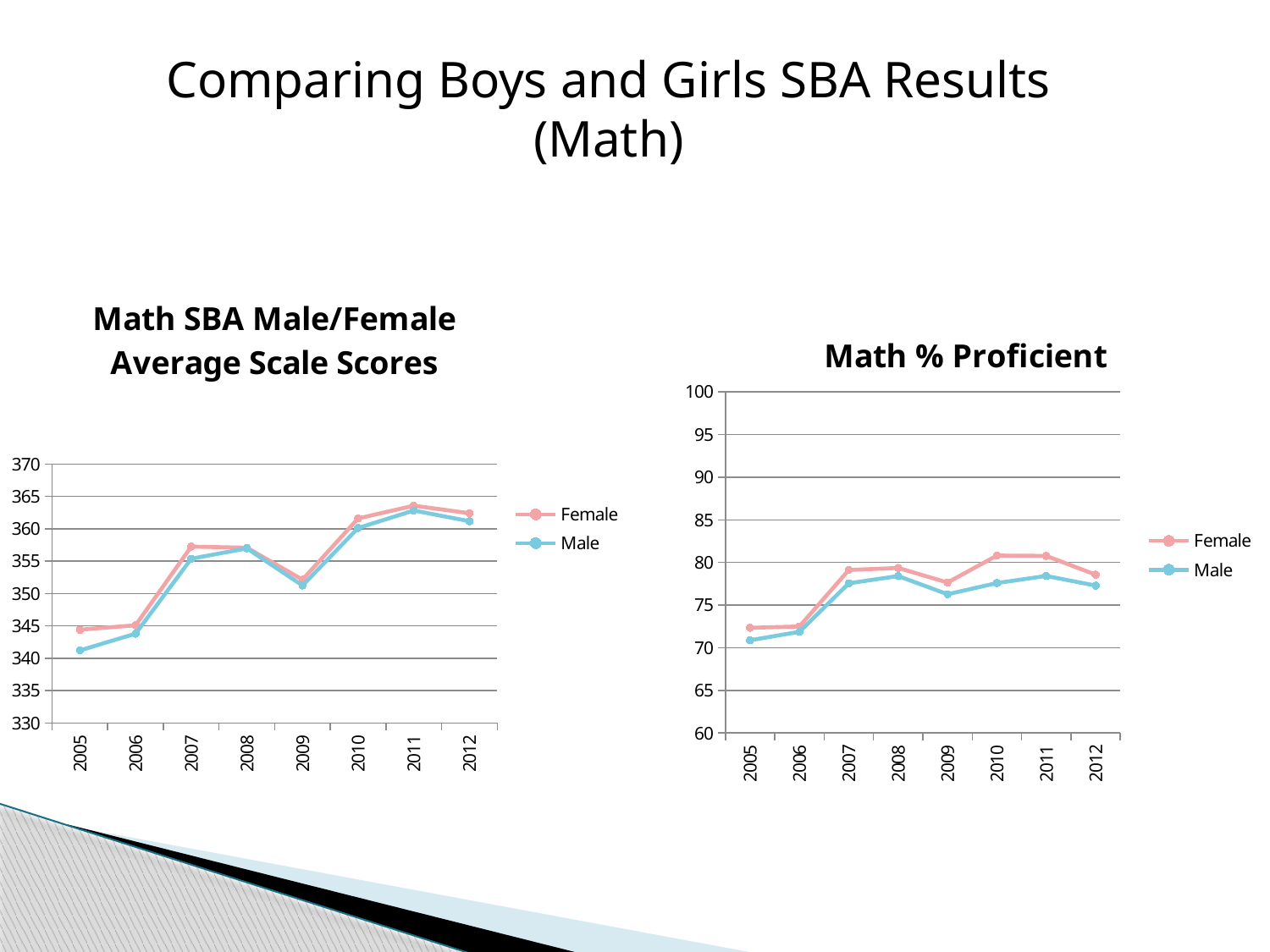
In the Math % Proficient chart, is the Male value for 2005 greater or less than 75? less How many years are plotted on the x axis of the Math % Proficient chart? 8 In the Math SBA Male/Female Average Scale Scores chart, is the Female value for 2007 greater or less than 355? greater In the Math SBA Male/Female Average Scale Scores chart, is the Male value for 2005 greater or less than 345? less In the Math SBA Male/Female Average Scale Scores chart, do the Female values rise or fall from 2009 to 2011? rise In the Math % Proficient chart, in which year is the Male series at its lowest? 2005 What kind of chart is the Math SBA Male/Female Average Scale Scores chart? line chart In the Math % Proficient chart, which series has the higher value in 2011, Female or Male? Female In the Math SBA Male/Female Average Scale Scores chart, in which year does the Female series reach its highest value? 2011 In the Math SBA Male/Female Average Scale Scores chart, in which year is the Male series at its lowest? 2005 In the Math SBA Male/Female Average Scale Scores chart, which series has the higher value in 2007, Female or Male? Female